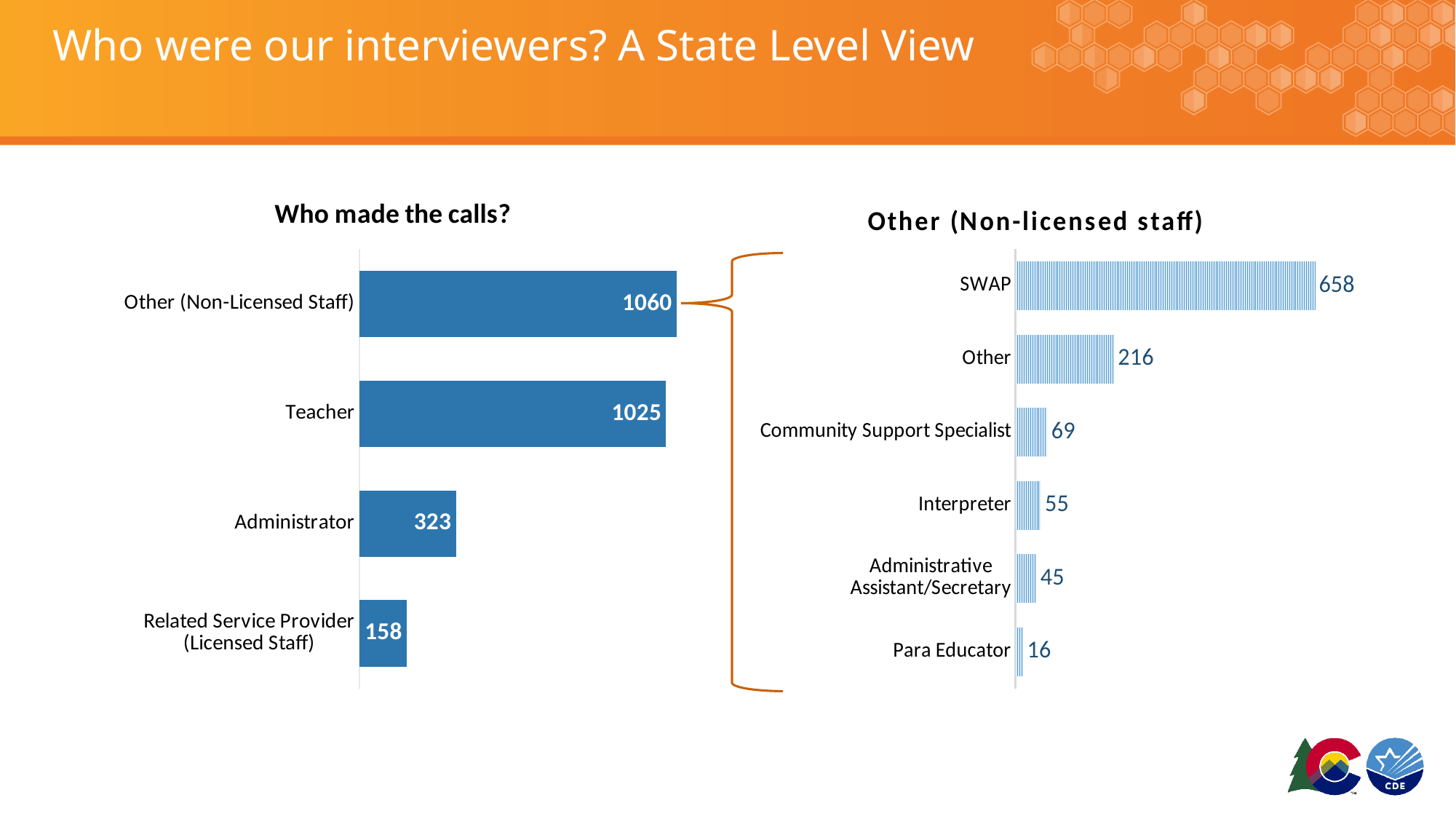
In the 'Who made the calls?' chart, what is the difference between Administrator and Related Service Provider (Licensed Staff)? 165 In the 'Who made the calls?' chart, which category has the highest value? Other (Non-Licensed Staff) In the 'Other (Non-licensed staff)' chart, which is larger: Community Support Specialist or Administrative Assistant/Secretary? Community Support Specialist In the 'Other (Non-licensed staff)' chart, what is the value for Interpreter? 55 In the 'Who made the calls?' chart, what is the value for Teacher? 1025 In the 'Other (Non-licensed staff)' chart, which category has the highest value? SWAP In the 'Other (Non-licensed staff)' chart, how many categories are shown? 6 In the 'Other (Non-licensed staff)' chart, what is the difference between SWAP and Other? 442 In the 'Who made the calls?' chart, which category has the lowest value? Related Service Provider (Licensed Staff) In the 'Who made the calls?' chart, how many categories are shown? 4 In the 'Who made the calls?' chart, what kind of chart is it? Bar chart In the 'Other (Non-licensed staff)' chart, which category has the lowest value? Para Educator